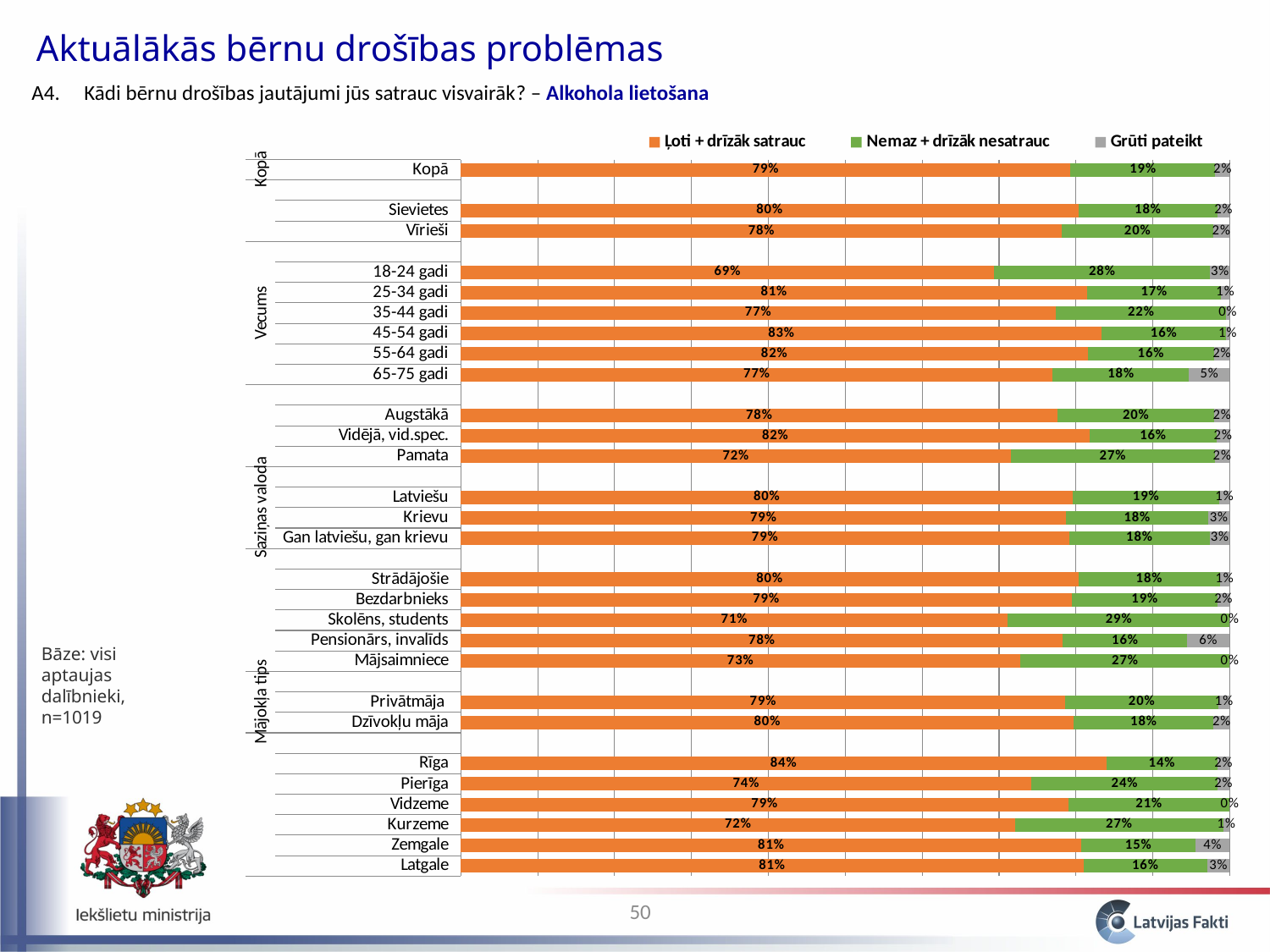
Which category has the highest value for "Ļoti + drīzāk satrauc"? Rīga What is the value of "Nemaz + drīzāk nesatrauc" for 18-24 gadi? 28% What is the value of "Ļoti + drīzāk satrauc" for Kopā? 79% What kind of chart is shown on the slide? Stacked bar chart How many series does the legend list? 3 Which series is shown in orange in the legend? Ļoti + drīzāk satrauc Which has a larger "Ļoti + drīzāk satrauc" value, Sievietes or Vīrieši? Sievietes What is the difference between the "Ļoti + drīzāk satrauc" values for Rīga and Pierīga? 10 percentage points What is the value of "Ļoti + drīzāk satrauc" for Kurzeme? 72% Which category has the lowest value for "Ļoti + drīzāk satrauc"? 18-24 gadi What is the value of "Grūti pateikt" for Pensionārs, invalīds? 6% What is the total of the stacked bar for Kopā? 100%